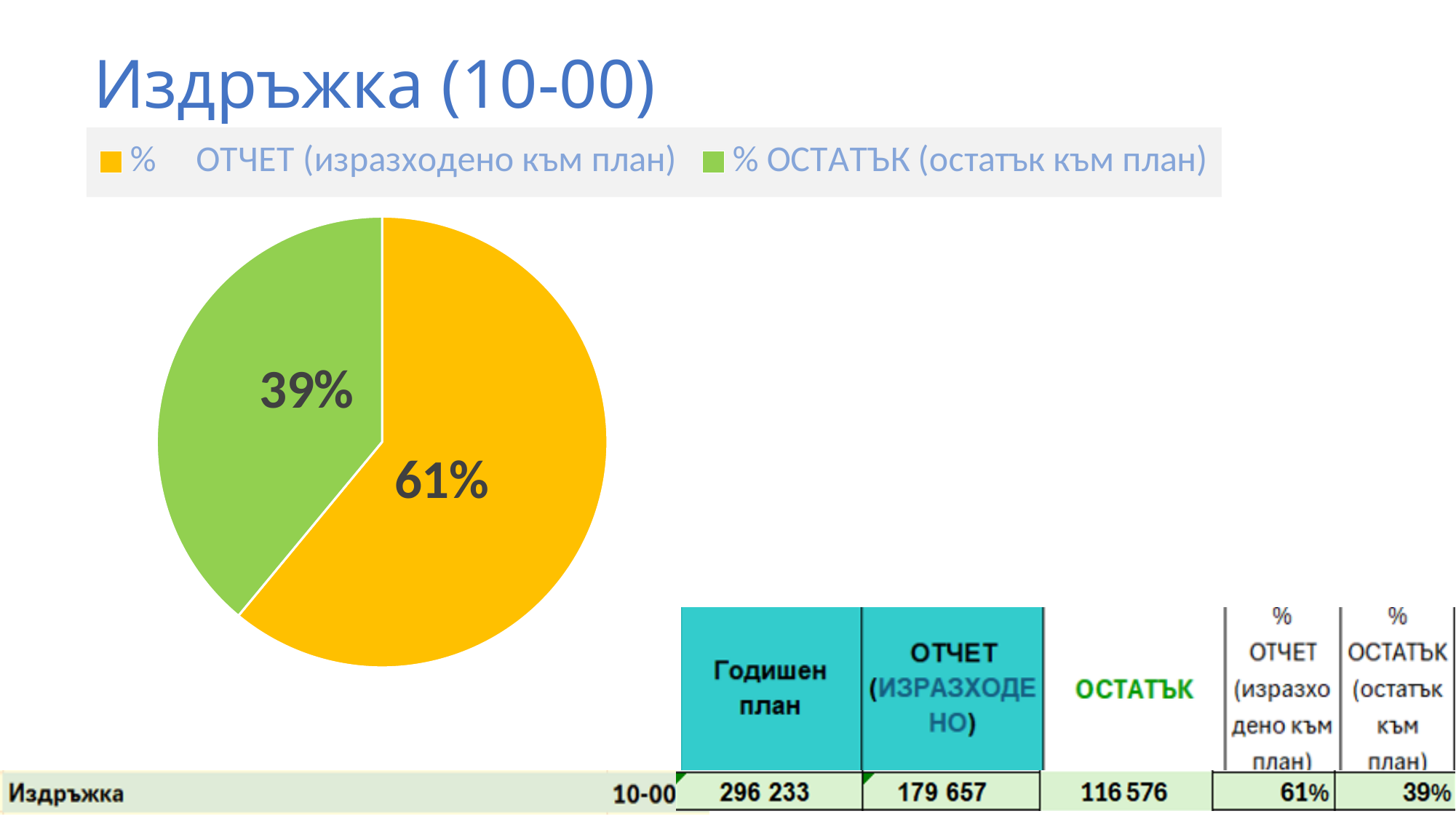
Which slice of the pie is the largest? % ОТЧЕТ (изразходено към план) What share of the pie does the "% ОСТАТЪК (остатък към план)" slice represent? 39% Is the value of the ОСТАТЪК slice greater or less than 50%? less Which is larger: the ОТЧЕТ slice or the ОСТАТЪК slice? ОТЧЕТ What is the title of the slide containing the pie chart? Издръжка (10-00) What colour is the "% ОСТАТЪК (остатък към план)" slice in the pie chart? green How many slices does the pie chart have? 2 How many entries does the legend list? 2 Which slice of the pie is the smallest? % ОСТАТЪК (остатък към план) What is the difference in percentage points between the ОТЧЕТ slice and the ОСТАТЪК slice? 22 What kind of chart is shown on the slide? pie chart What share of the pie does the "% ОТЧЕТ (изразходено към план)" slice represent? 61%